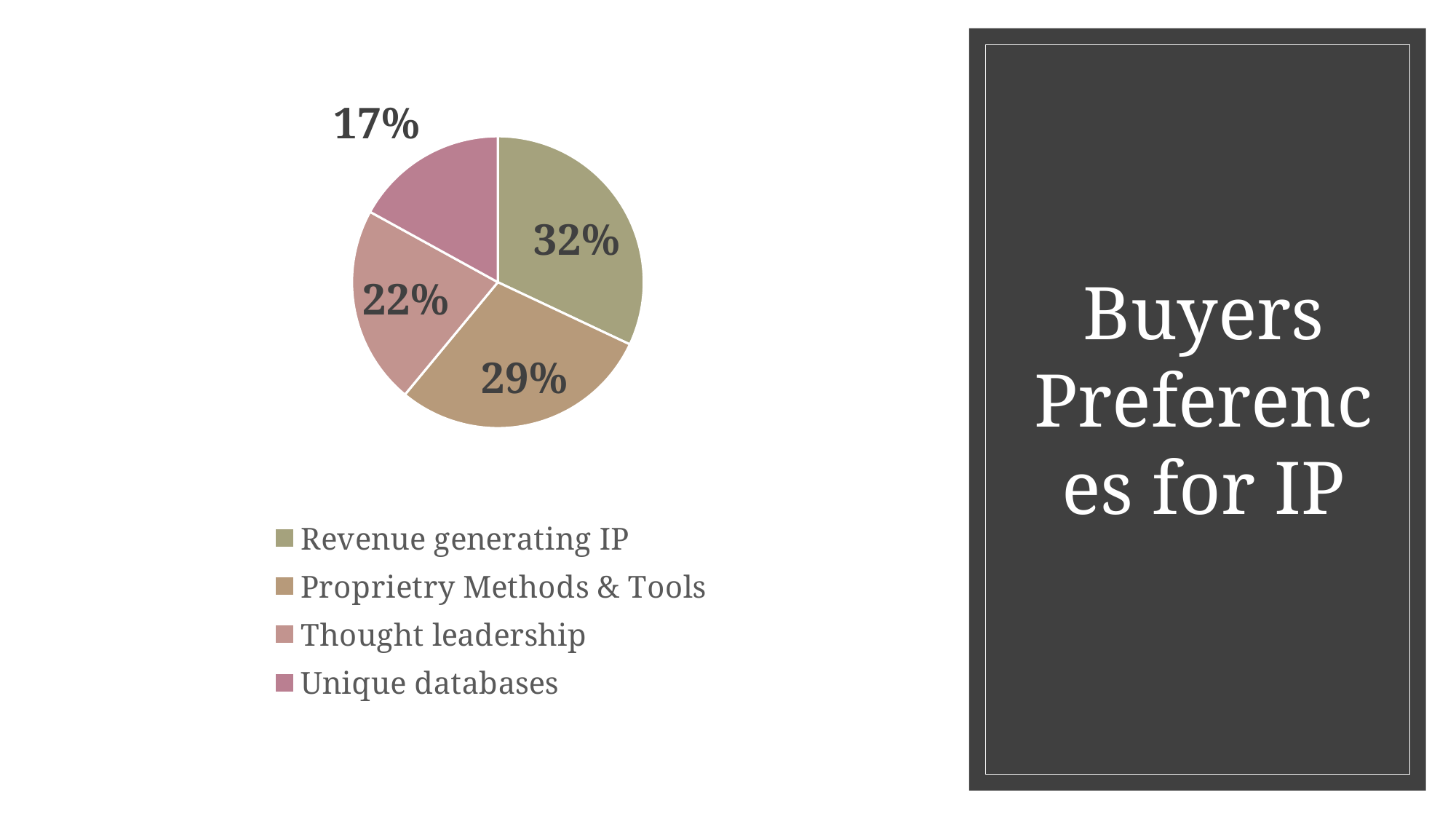
What share of the pie does Proprietry Methods & Tools have? 29% Which category has the largest slice of the pie? Revenue generating IP Which category has the smallest slice of the pie? Unique databases What is the difference in percentage points between Proprietry Methods & Tools and Thought leadership? 7 How many slices does the pie chart have? 4 What share of the pie does Unique databases have? 17% What share of the pie does Revenue generating IP have? 32% Which is larger, the share for Thought leadership or the share for Unique databases? Thought leadership What kind of chart is shown on the slide? Pie chart What is the title shown on the slide next to the chart? Buyers Preferences for IP What is the difference in percentage points between Revenue generating IP and Unique databases? 15